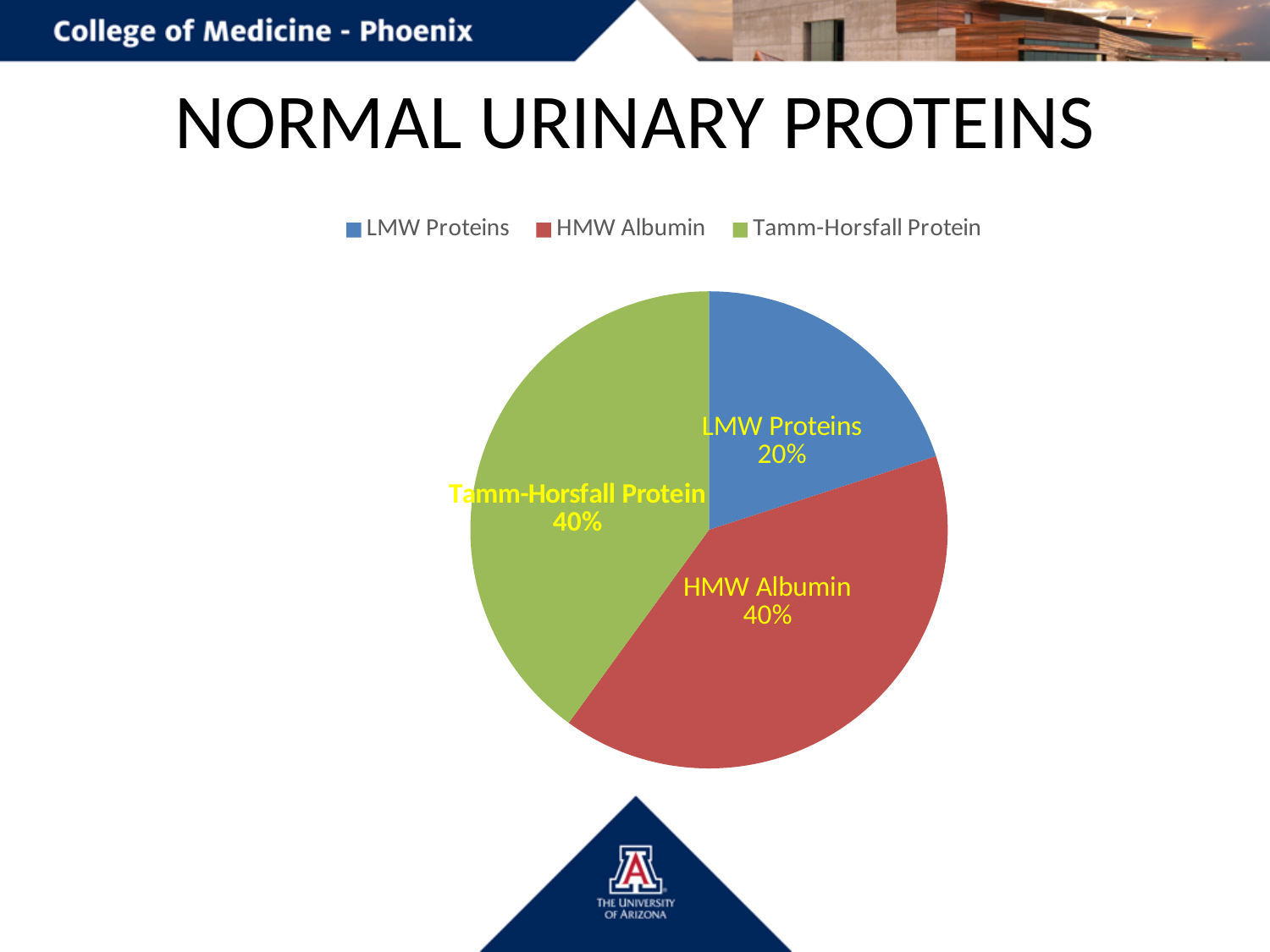
What share of the pie is HMW Albumin? 40% What is the difference between the shares of HMW Albumin and LMW Proteins? 20% What share of the pie is LMW Proteins? 20% What is the title of the slide containing the pie chart? NORMAL URINARY PROTEINS What share of the pie is Tamm-Horsfall Protein? 40% How many entries does the legend list? 3 What kind of chart is shown on the slide? pie chart What colour is the slice for Tamm-Horsfall Protein? green How many slices does the pie chart have? 3 Which category has the smallest slice of the pie? LMW Proteins What is the combined share of HMW Albumin and Tamm-Horsfall Protein? 80% Which is larger, the share for HMW Albumin or the share for LMW Proteins? HMW Albumin